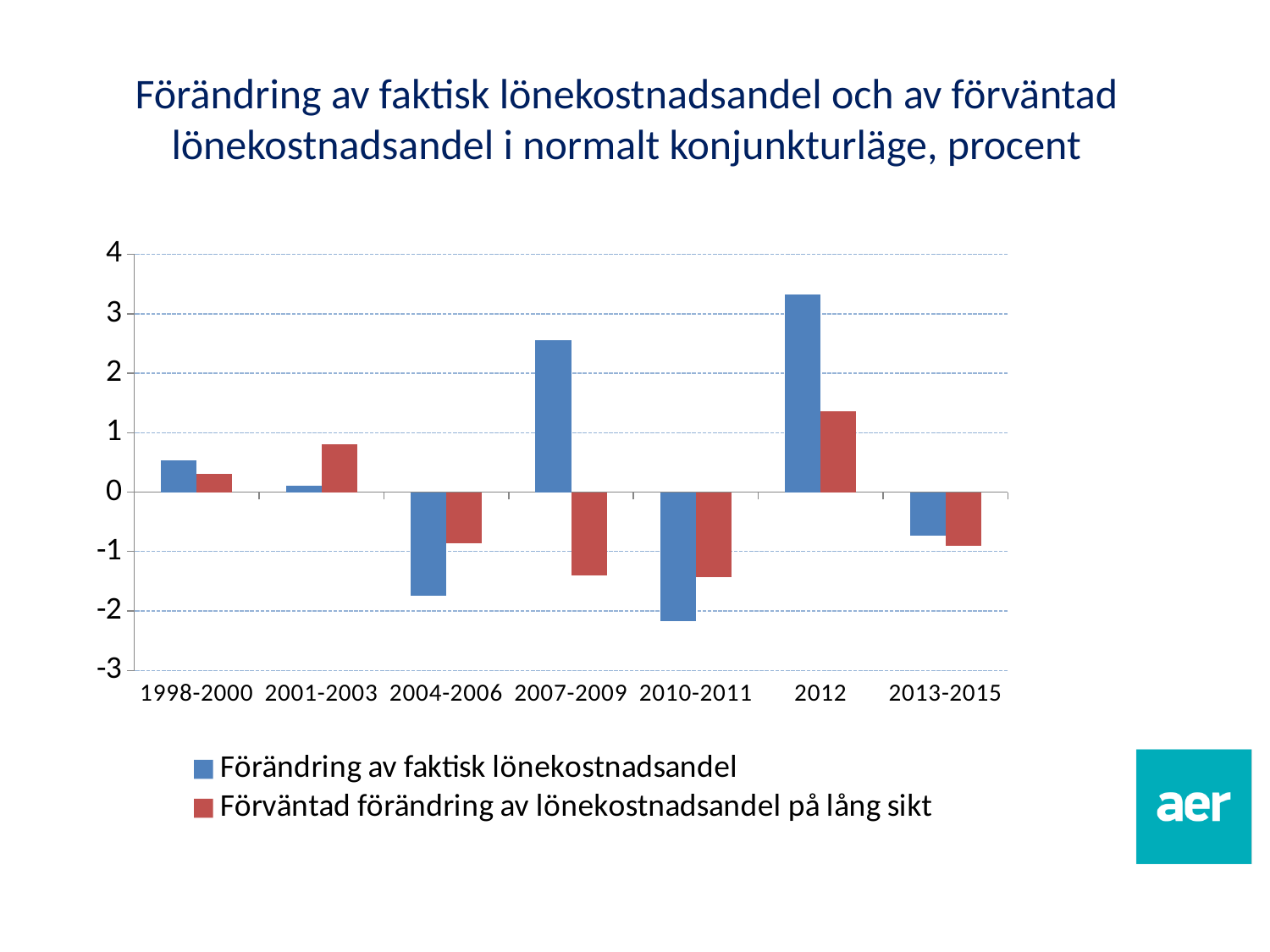
In which period is the value for 'Förändring av faktisk lönekostnadsandel' lowest? 2010-2011 Is the value for 'Förändring av faktisk lönekostnadsandel' in 2012 greater or less than 3? greater How many period categories are shown on the x axis? 7 Is the value for 'Förändring av faktisk lönekostnadsandel' in 2007-2009 greater or less than 2? greater Which colour represents 'Förändring av faktisk lönekostnadsandel' in the legend? blue Is the value for 'Förändring av faktisk lönekostnadsandel' in 2010-2011 greater or less than -2? less In 2001-2003, which series has the larger value? Förväntad förändring av lönekostnadsandel på lång sikt In which period is the value for 'Förändring av faktisk lönekostnadsandel' highest? 2012 What kind of chart is shown on the slide? bar chart In which period is the value for 'Förväntad förändring av lönekostnadsandel på lång sikt' highest? 2012 How many series does the legend list? 2